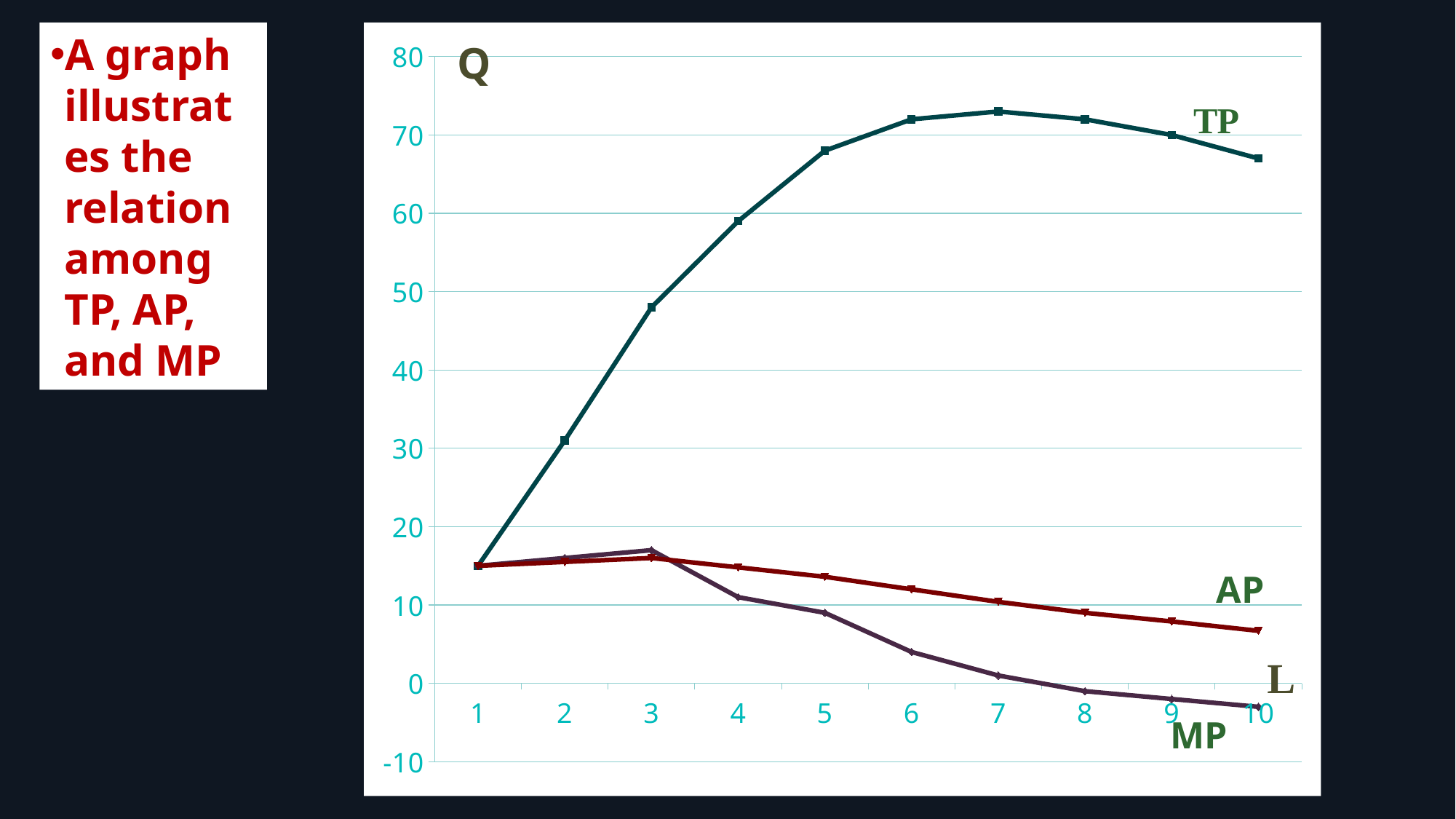
How many series are plotted on the chart? 3 At which value of L does the TP curve reach its highest point? 7 Which is larger at L = 10, AP or MP? AP What label is written on the vertical axis of the chart? Q How many points along the L axis does each series have? 10 At which value of L is the TP curve at its lowest? 1 Is the value of TP at L = 5 greater or less than 60? greater Is the value of TP at L = 3 greater or less than 40? greater What kind of chart is shown on the slide? line chart Does the MP curve rise or fall from L = 3 to L = 10? fall Is the value of AP at L = 10 greater or less than 10? less